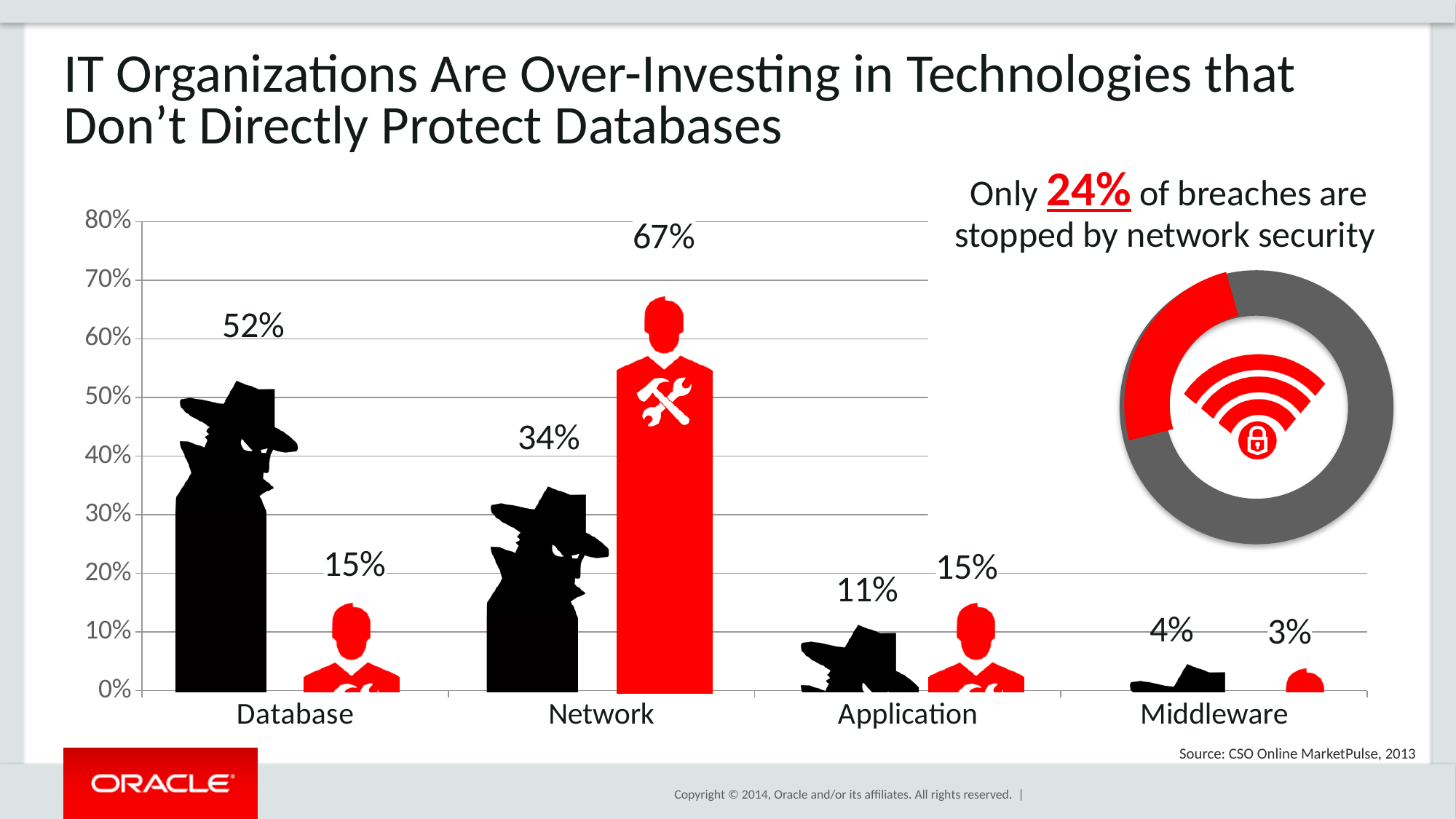
What value is shown for the red bar in the Middleware category? 3% What value is shown for the black bar in the Application category? 11% What is the source cited for the data on the slide? CSO Online MarketPulse, 2013 What value is shown for the black bar in the Database category? 52% In the Database category, which is larger, the black bar or the red bar? The black bar Which category has the highest black bar? Database What kind of chart is the main chart on the left of the slide? Bar chart How many categories are shown on the x axis of the bar chart? 4 What is the difference between the red bar and the black bar in the Network category? 33% What value is shown for the red bar in the Network category? 67% Which category has the lowest red bar? Middleware According to the donut chart on the right, what percentage of breaches are stopped by network security? 24%